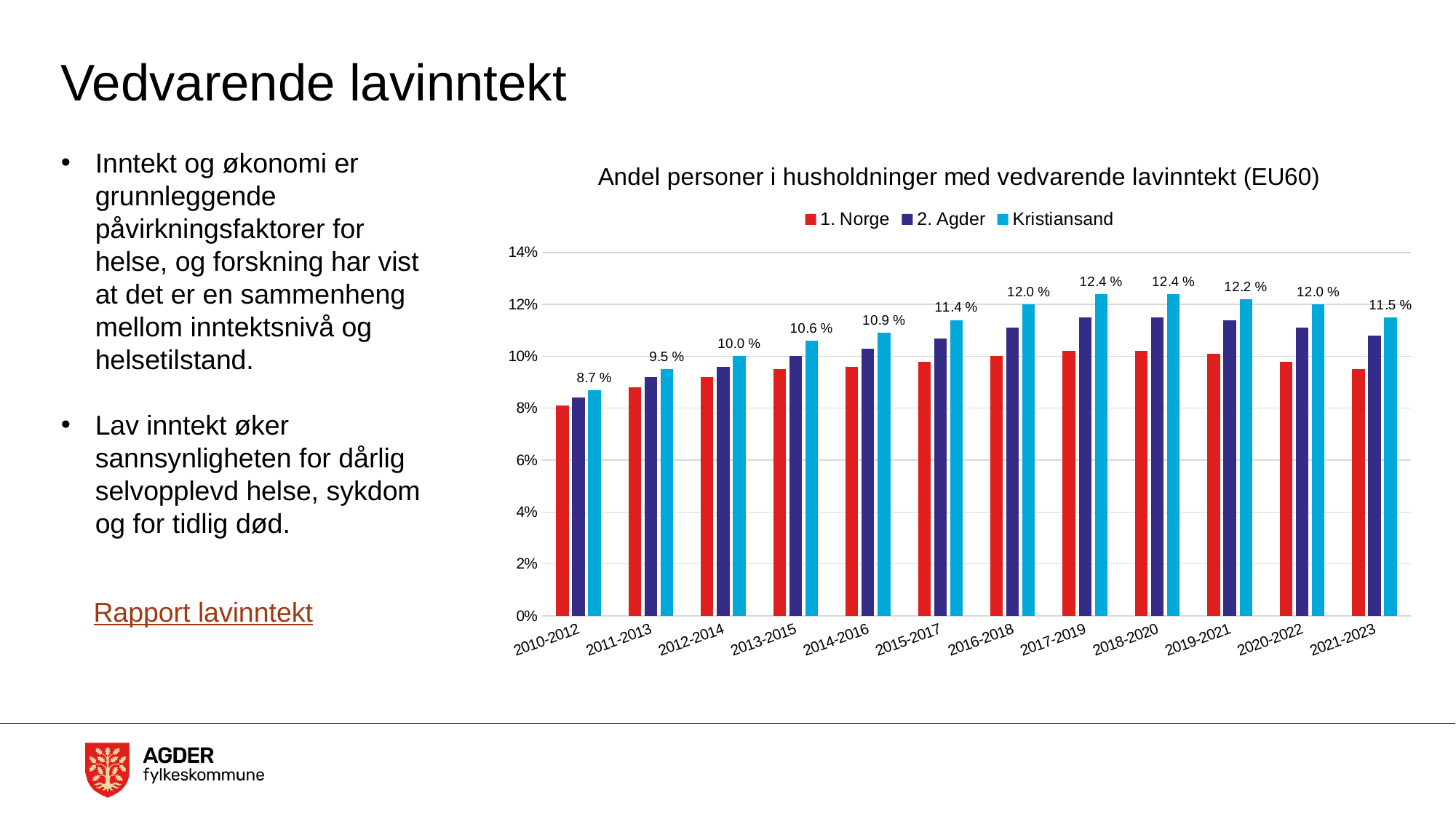
In which period is the Kristiansand value lowest? 2010-2012 What is the value for Kristiansand in 2021-2023? 11.5 % What is the highest value shown for Kristiansand? 12.4 % Is the value for 1. Norge in 2021-2023 greater or less than 10%? less What is the difference between the Kristiansand values for 2021-2023 and 2010-2012? 2.8 % In 2017-2019, which is larger: the value for 1. Norge or for Kristiansand? Kristiansand What is the value for Kristiansand in 2015-2017? 11.4 % Which series is shown in red in the legend? 1. Norge What type of chart is shown on the slide? Bar chart How many series does the legend list? 3 What is the value for Kristiansand in 2010-2012? 8.7 % How many time periods are shown on the x axis? 12